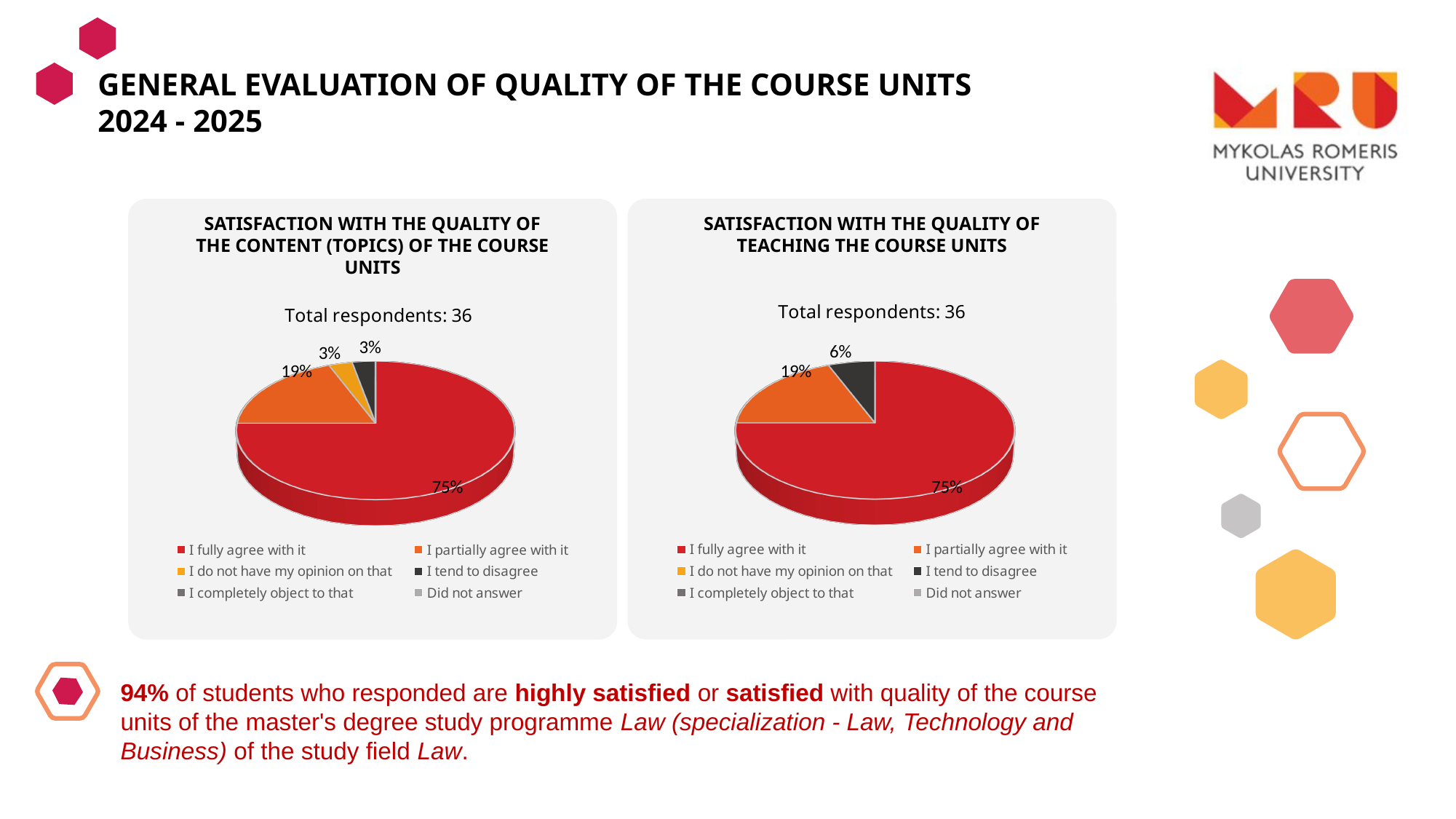
In the chart titled 'Satisfaction with the quality of the content (topics) of the course units', which response has the largest share? I fully agree with it In the chart titled 'Satisfaction with the quality of teaching the course units', what share of respondents chose 'I tend to disagree'? 6% What type of chart is used in the chart titled 'Satisfaction with the quality of teaching the course units'? Pie chart In the chart titled 'Satisfaction with the quality of the content (topics) of the course units', what share of respondents chose 'I fully agree with it'? 75% In the chart titled 'Satisfaction with the quality of teaching the course units', what share of respondents chose 'I partially agree with it'? 19% How many entries does the legend list in the chart titled 'Satisfaction with the quality of the content (topics) of the course units'? 6 In the chart titled 'Satisfaction with the quality of teaching the course units', which response has the smallest share? I tend to disagree In the chart titled 'Satisfaction with the quality of the content (topics) of the course units', what share of respondents chose 'I partially agree with it'? 19% In the chart titled 'Satisfaction with the quality of teaching the course units', what is the difference between the 'I fully agree with it' share and the 'I partially agree with it' share? 56 percentage points How many slices are shown in the pie chart titled 'Satisfaction with the quality of teaching the course units'? 3 How many total respondents are reported for the chart titled 'Satisfaction with the quality of the content (topics) of the course units'? 36 In the chart titled 'Satisfaction with the quality of the content (topics) of the course units', which is larger: the share for 'I partially agree with it' or the share for 'I tend to disagree'? I partially agree with it